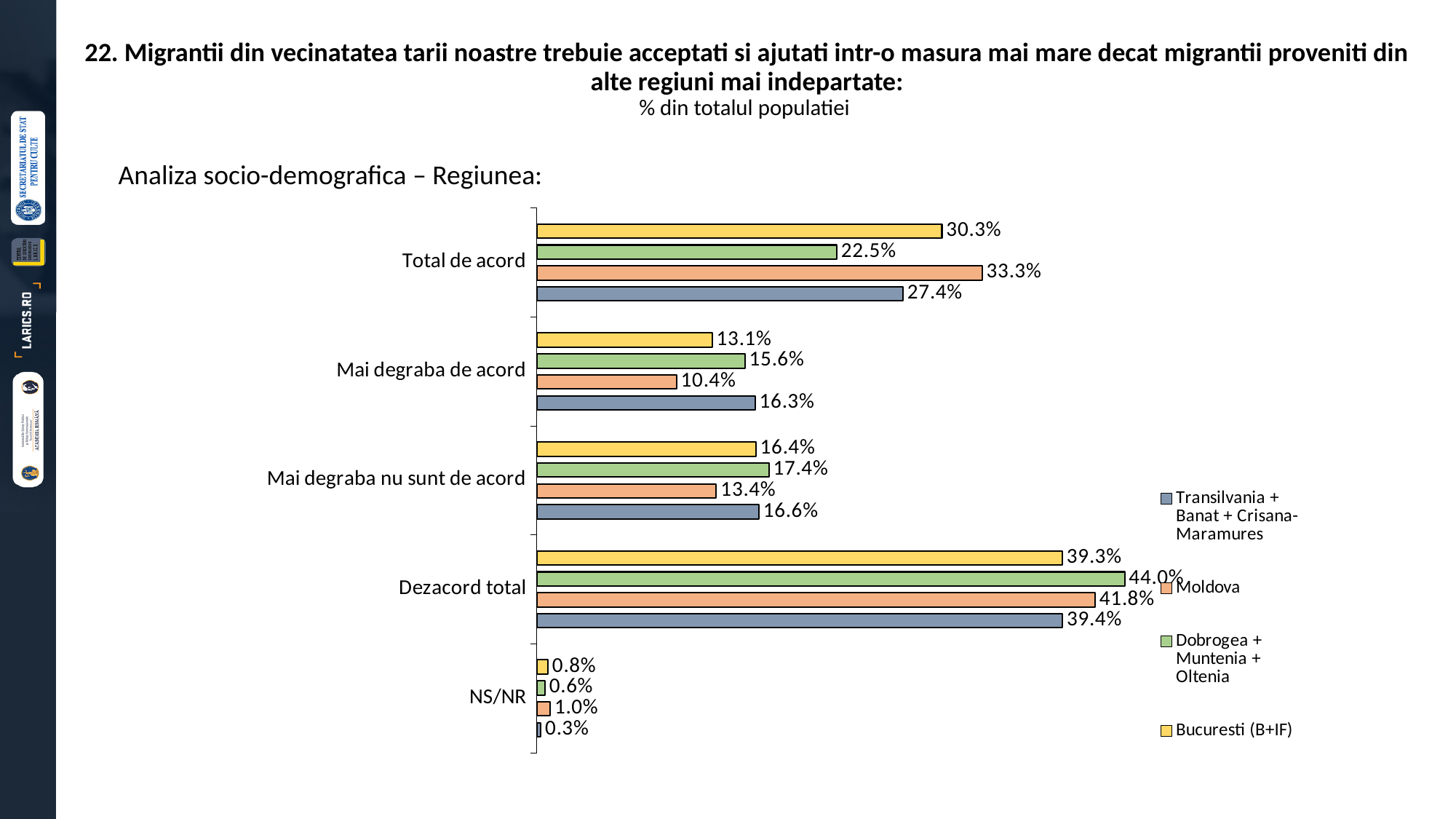
How many response categories are shown on the chart? 5 What kind of chart is shown on the slide? bar chart In the 'Mai degraba de acord' category, which is larger: Transilvania + Banat + Crisana-Maramures or Moldova? Transilvania + Banat + Crisana-Maramures What is the value for Moldova in the 'Total de acord' category? 33.3% Which region has the highest value in the 'Dezacord total' category? Dobrogea + Muntenia + Oltenia What is the difference between Moldova and Dobrogea + Muntenia + Oltenia in the 'Total de acord' category? 10.8% Which colour represents Moldova in the chart? orange Which region has the lowest value in the 'Total de acord' category? Dobrogea + Muntenia + Oltenia How many series does the legend list? 4 What is the value for Dobrogea + Muntenia + Oltenia in the 'Mai degraba de acord' category? 15.6% What is the value for Transilvania + Banat + Crisana-Maramures in the 'NS/NR' category? 0.3% What is the value for Bucuresti (B+IF) in the 'Dezacord total' category? 39.3%